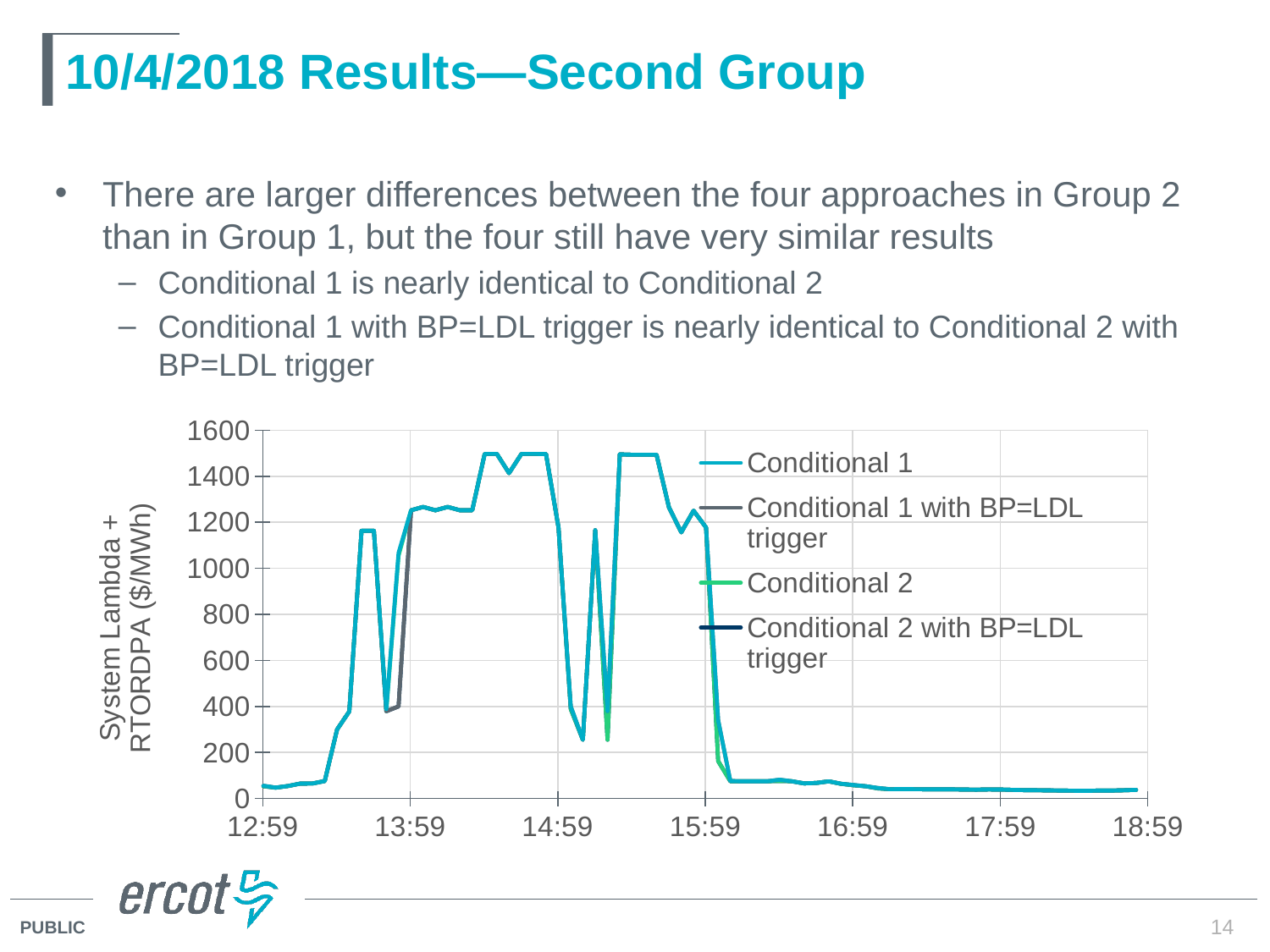
How many series does the chart legend list? 4 What is the highest tick value shown on the vertical axis? 1600 What kind of chart is shown on the slide? line chart Is the value for Conditional 1 at 16:59 greater or less than 200? less What is the label on the vertical axis of the chart? System Lambda + RTORDPA ($/MWh) Do the values for Conditional 1 rise or fall between 12:59 and 13:59? rise Is the highest value reached by Conditional 1 greater or less than 1400? greater Do the values for Conditional 1 rise or fall between 15:59 and 16:59? fall What is the first series listed in the chart legend? Conditional 1 Is the value for Conditional 1 at 18:59 greater or less than 200? less